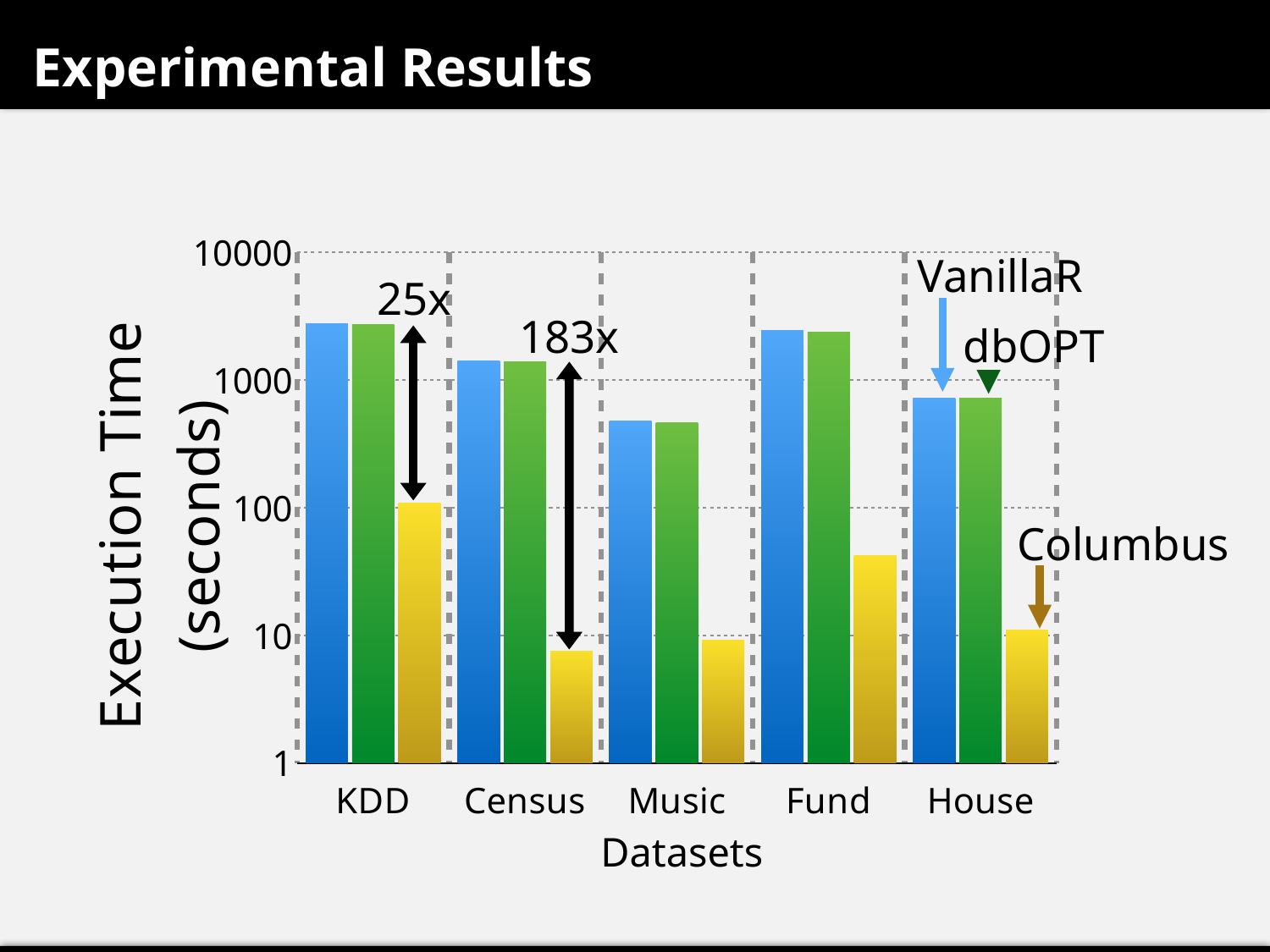
Is the execution time of VanillaR on the Music dataset greater or less than 1000 seconds? less On which dataset does VanillaR have the lowest execution time? Music Is the execution time of Columbus on the Fund dataset greater or less than 100 seconds? less What speedup factor is annotated above the Census dataset bars? 183x How many datasets are shown on the x axis of the chart? 5 Is the execution time of Columbus on the Census dataset greater or less than 10 seconds? less What kind of chart is shown on the slide? bar chart On which dataset does Columbus have the lowest execution time? Census Which has the larger execution time on the Fund dataset, VanillaR or Columbus? VanillaR What is the label of the y axis of the chart? Execution Time (seconds) How many series (methods) are plotted in the chart? 3